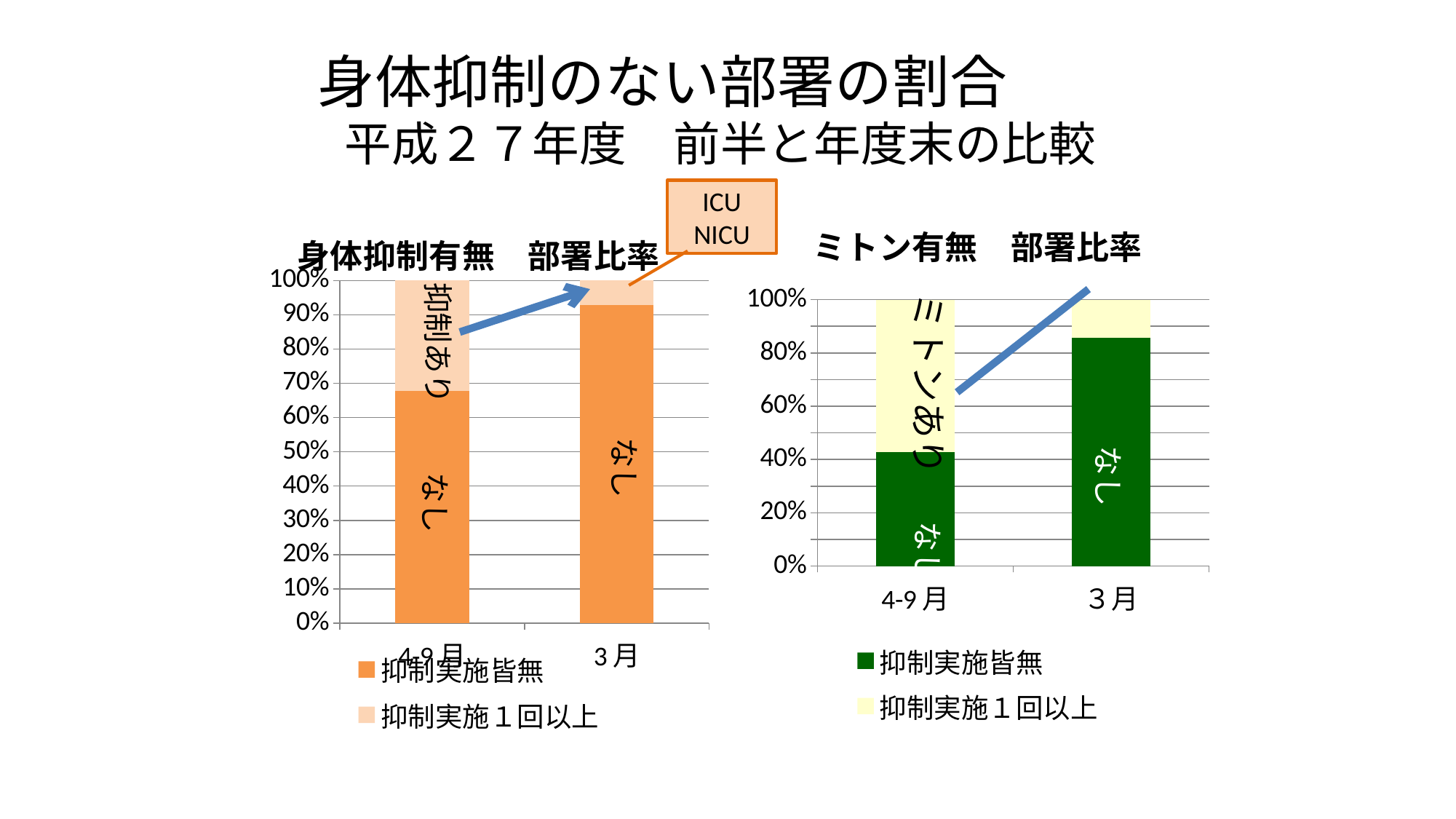
What are the two legend entries of the left chart (身体抑制有無 部署比率)? 抑制実施皆無, 抑制実施1回以上 In the left chart (身体抑制有無 部署比率), is the 抑制実施皆無 share for 3月 greater or less than 90%? greater In the right chart (ミトン有無 部署比率), which category has the larger 抑制実施1回以上 share, 4-9月 or 3月? 4-9月 In the right chart (ミトン有無 部署比率), is the 抑制実施皆無 share for 3月 greater or less than 80%? greater In the left chart (身体抑制有無 部署比率), is the 抑制実施皆無 share for 4-9月 greater or less than 60%? greater In the right chart (ミトン有無 部署比率), does the 抑制実施皆無 share rise or fall from 4-9月 to 3月? rise In the left chart (身体抑制有無 部署比率), how many categories are shown on the x axis? 2 What kind of chart is the right chart titled ミトン有無 部署比率? stacked bar chart What kind of chart is the left chart titled 身体抑制有無 部署比率? stacked bar chart In the right chart (ミトン有無 部署比率), how many series does the legend list? 2 In the left chart (身体抑制有無 部署比率), which category has the larger 抑制実施皆無 share, 4-9月 or 3月? 3月